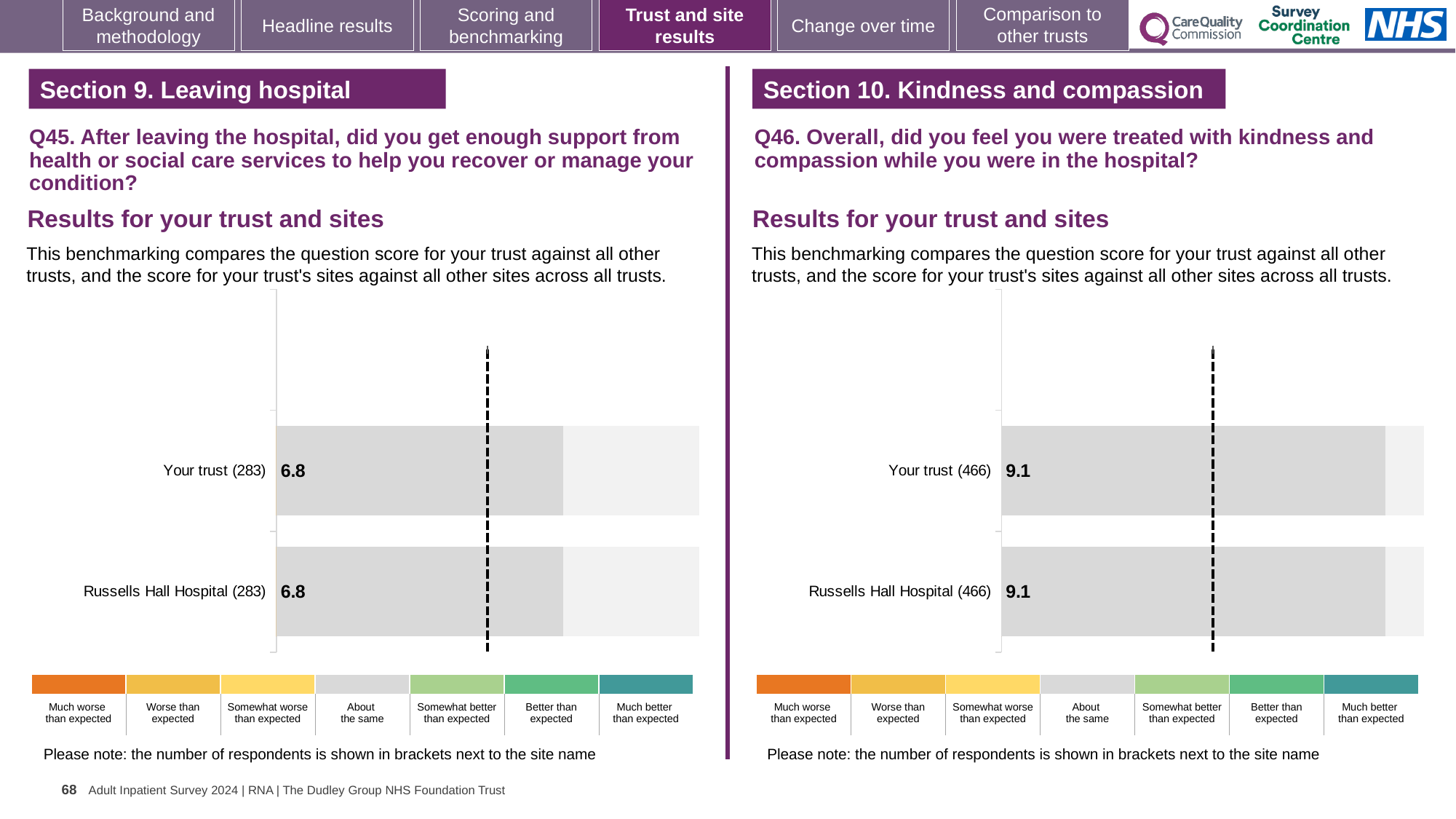
In the Q45 chart on the left, what is the difference between the score for Your trust and the score for Russells Hall Hospital? 0 In the colour key below the Q46 chart on the right, which category is shown in orange? Much worse than expected What kind of chart is used for the Q45 results on the left? Bar chart In the Q45 chart on the left, what is the score for Russells Hall Hospital? 6.8 In the Q46 chart on the right, how many respondents are shown in brackets for Russells Hall Hospital? 466 In the Q46 chart on the right, what is the score for Russells Hall Hospital? 9.1 In the Q45 chart on the left, how many respondents are shown in brackets for Your trust? 283 How many benchmark categories are listed in the colour key below the Q45 chart on the left? 7 In the Q46 chart on the right, what is the score for Your trust? 9.1 In the Q45 chart on the left, what is the score for Your trust? 6.8 How many bars are plotted in the Q46 chart on the right? 2